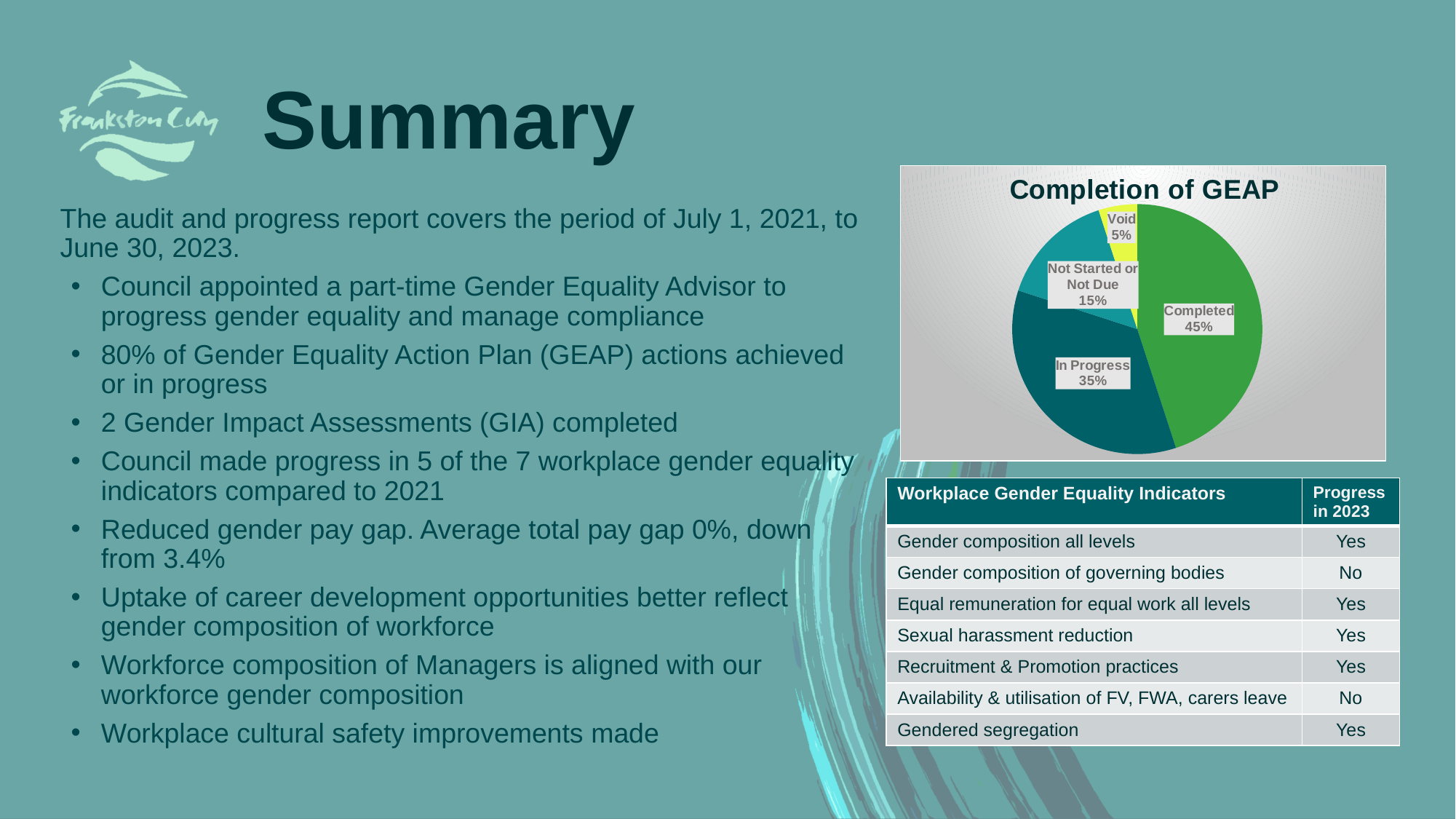
Which slice of the pie chart is the smallest? Void Which slice of the pie chart is the largest? Completed What share of the pie is labelled Completed? 45% How many slices does the pie chart have? 4 What is the difference in percentage points between the Completed and In Progress slices? 10 What share of the pie is labelled Void? 5% What share of the pie is labelled Not Started or Not Due? 15% Which is larger, the In Progress slice or the Not Started or Not Due slice? In Progress What type of chart is shown on the slide? pie chart What share of the pie is labelled In Progress? 35% What is the combined share of the Completed and In Progress slices? 80% What is the title of the pie chart? Completion of GEAP